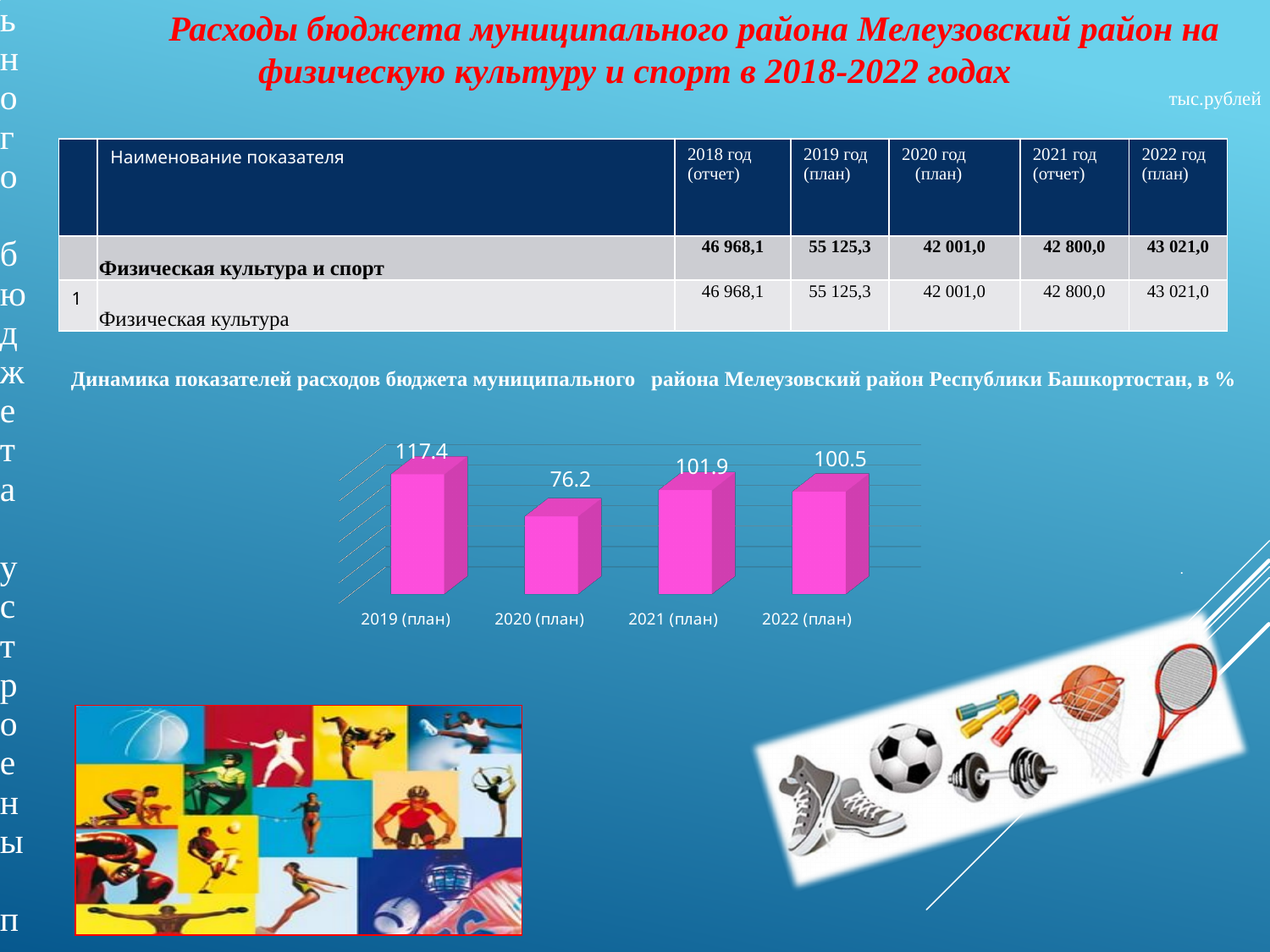
What kind of chart is shown on the slide? bar chart What is the value for 2019 (план) on the chart? 117.4 What is the value for 2022 (план) on the chart? 100.5 Which category has the lowest value on the chart? 2020 (план) Does the value fall or rise from 2019 (план) to 2020 (план)? fall What is the difference between the values for 2019 (план) and 2020 (план)? 41.2 What is the difference between the values for 2021 (план) and 2022 (план)? 1.4 Which is larger, the value for 2019 (план) or the value for 2021 (план)? 2019 (план) How many categories are shown on the chart? 4 What is the value for 2020 (план) on the chart? 76.2 What is the value for 2021 (план) on the chart? 101.9 Which category has the highest value on the chart? 2019 (план)